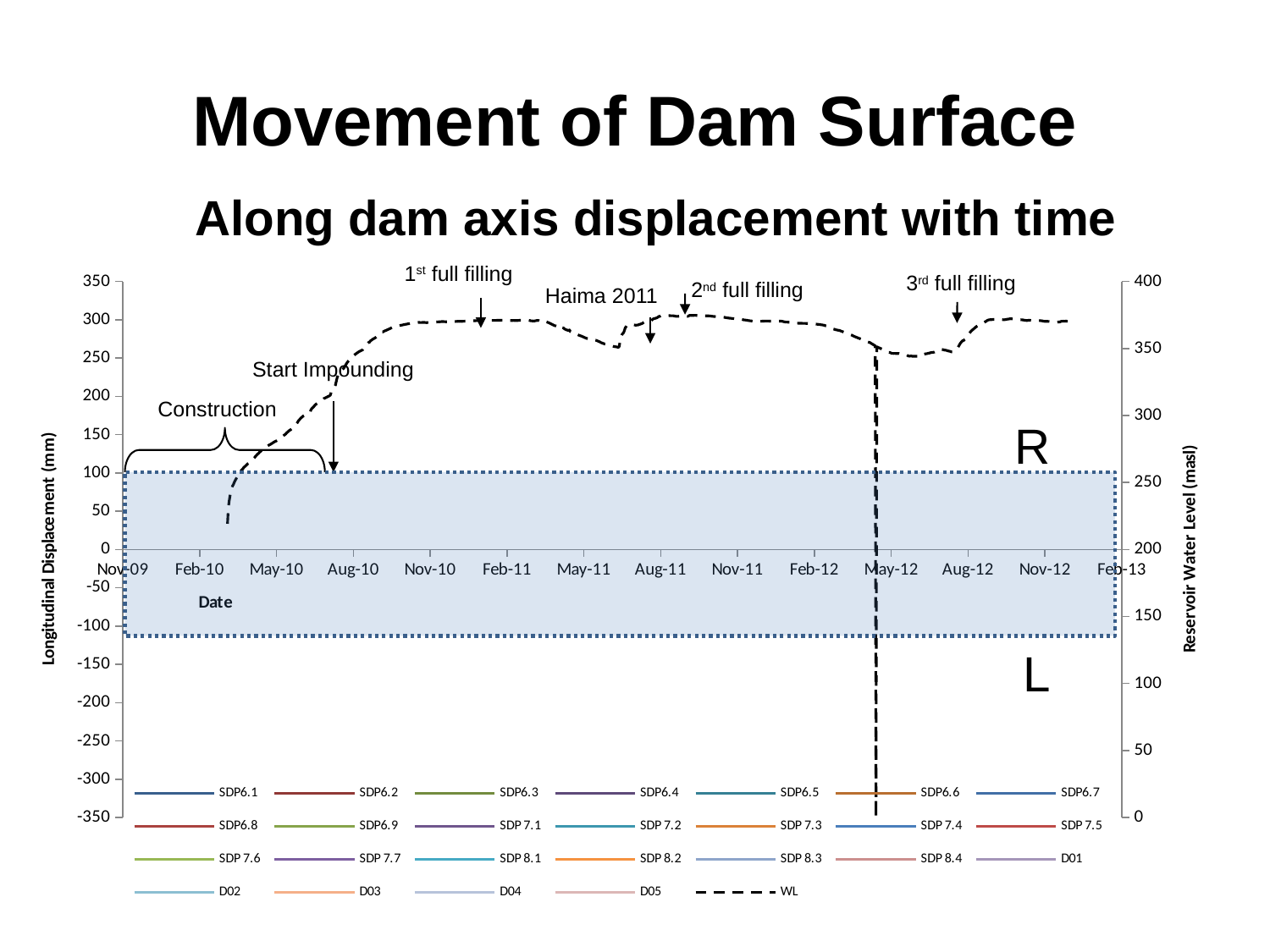
Is the reservoir water level (WL) at May-10 greater or less than 250 masl? greater Which event annotation is marked on the chart around Aug-11? Haima 2011 Does the reservoir water level (WL) rise or fall between May-10 and Nov-10? rise Does the reservoir water level (WL) rise or fall between Feb-12 and May-12? fall What is the title of the chart on the slide? Along dam axis displacement with time What kind of chart is shown on the slide? line chart How many date ticks are shown along the x axis? 14 How many series does the legend list? 26 Is the reservoir water level (WL) at Nov-10 greater or less than 350 masl? greater What is the label of the right-hand vertical axis? Reservoir Water Level (masl) Is the reservoir water level (WL) at Feb-11 greater or less than 350 masl? greater Which is higher, the reservoir water level (WL) at Feb-11 or at May-10? Feb-11